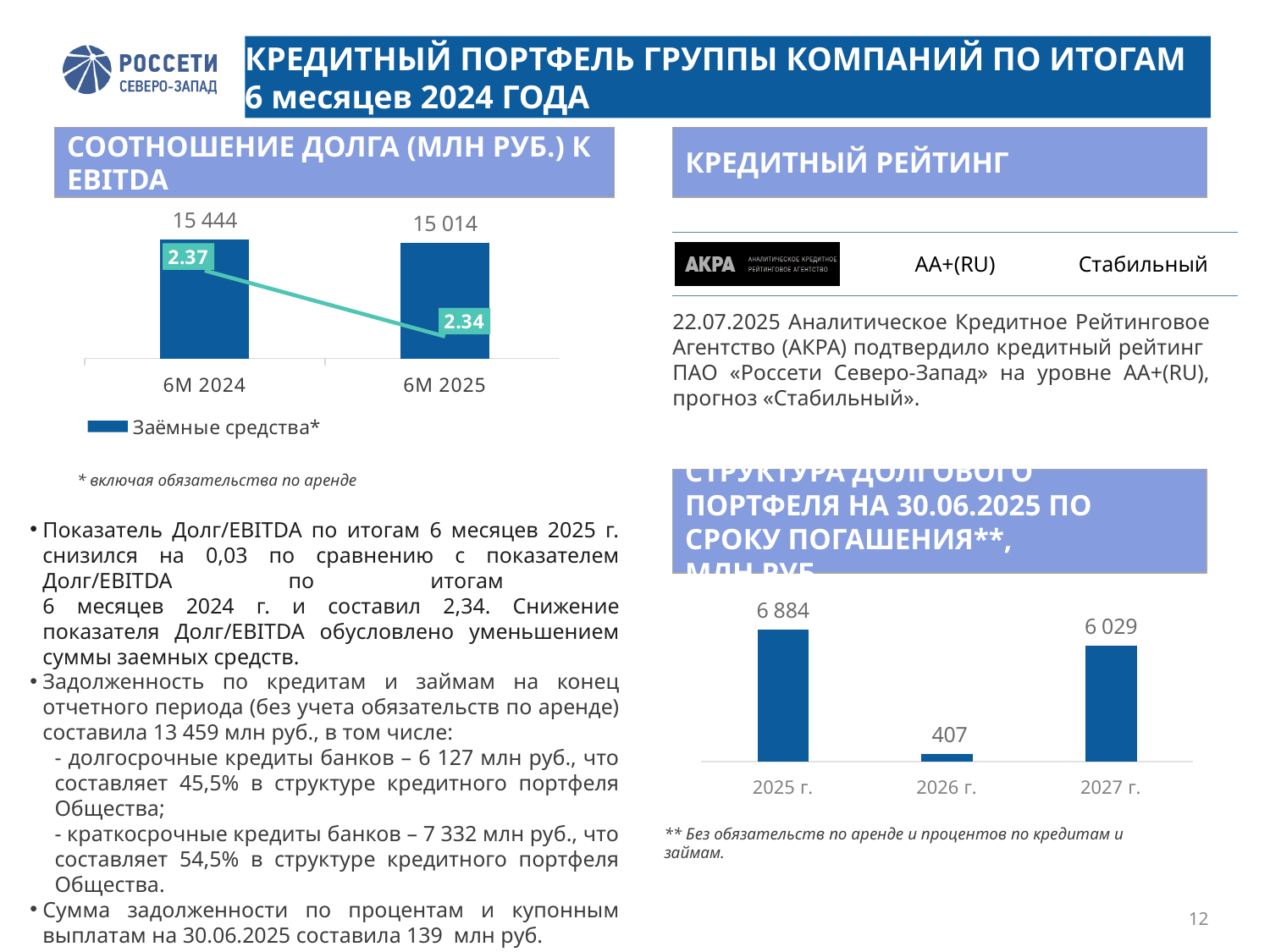
In the 'Структура долгового портфеля на 30.06.2025 по сроку погашения' chart, what is the value for 2026 г.? 407 In the 'Структура долгового портфеля на 30.06.2025 по сроку погашения' chart, which year has the lowest value? 2026 г. In the 'Соотношение долга (млн руб.) к EBITDA' chart, does the Debt/EBITDA line rise or fall from 6M 2024 to 6M 2025? fall In the 'Структура долгового портфеля на 30.06.2025 по сроку погашения' chart, which year has the highest value? 2025 г. In the 'Соотношение долга (млн руб.) к EBITDA' chart, what is the Debt/EBITDA ratio shown for 6M 2024? 2.37 In the 'Соотношение долга (млн руб.) к EBITDA' chart, by how much did Заёмные средства decrease from 6M 2024 to 6M 2025? 430 In the 'Соотношение долга (млн руб.) к EBITDA' chart, what series does the legend list? Заёмные средства* In the 'Структура долгового портфеля на 30.06.2025 по сроку погашения' chart, what is the difference between the values for 2025 г. and 2027 г.? 855 In the 'Соотношение долга (млн руб.) к EBITDA' chart, what is the value of Заёмные средства for 6M 2024? 15 444 In the 'Соотношение долга (млн руб.) к EBITDA' chart, what is the value of Заёмные средства for 6M 2025? 15 014 In the 'Структура долгового портфеля на 30.06.2025 по сроку погашения' chart, what is the value for 2025 г.? 6 884 In the 'Соотношение долга (млн руб.) к EBITDA' chart, what is the Debt/EBITDA ratio shown for 6M 2025? 2.34